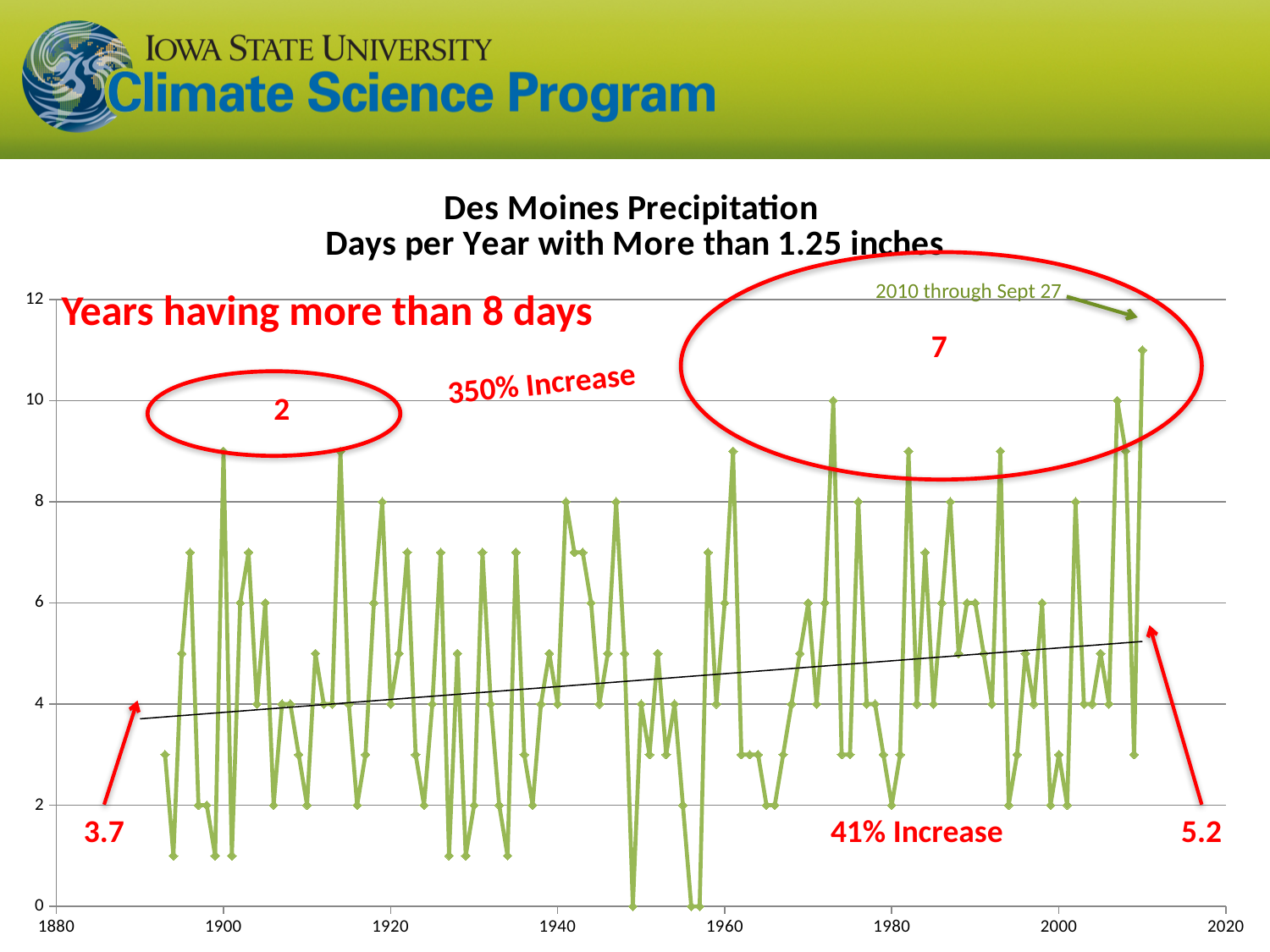
How many years having more than 8 days are circled in the early period (around 1900-1920)? 2 What percentage increase does the slide give for the number of years having more than 8 days? 350% Increase What kind of chart is shown on the slide? line chart What percentage increase does the slide give for the trend line? 41% Increase What is the title of the chart? Des Moines Precipitation Days per Year with More than 1.25 inches According to the trend line annotation, what is the value at the end of the trend line (around 2010)? 5.2 Is the value for 2010 (through Sept 27) greater or less than 10? greater By how much does the trend line rise from its start value (3.7) to its end value (5.2)? 1.5 Does the trend line rise or fall from 1890 to 2010? rises According to the trend line annotation, what is the value at the start of the trend line (around 1890)? 3.7 How many years having more than 8 days are circled in the later period (around 1970-2010)? 7 What is the lowest value reached by the line on the chart? 0